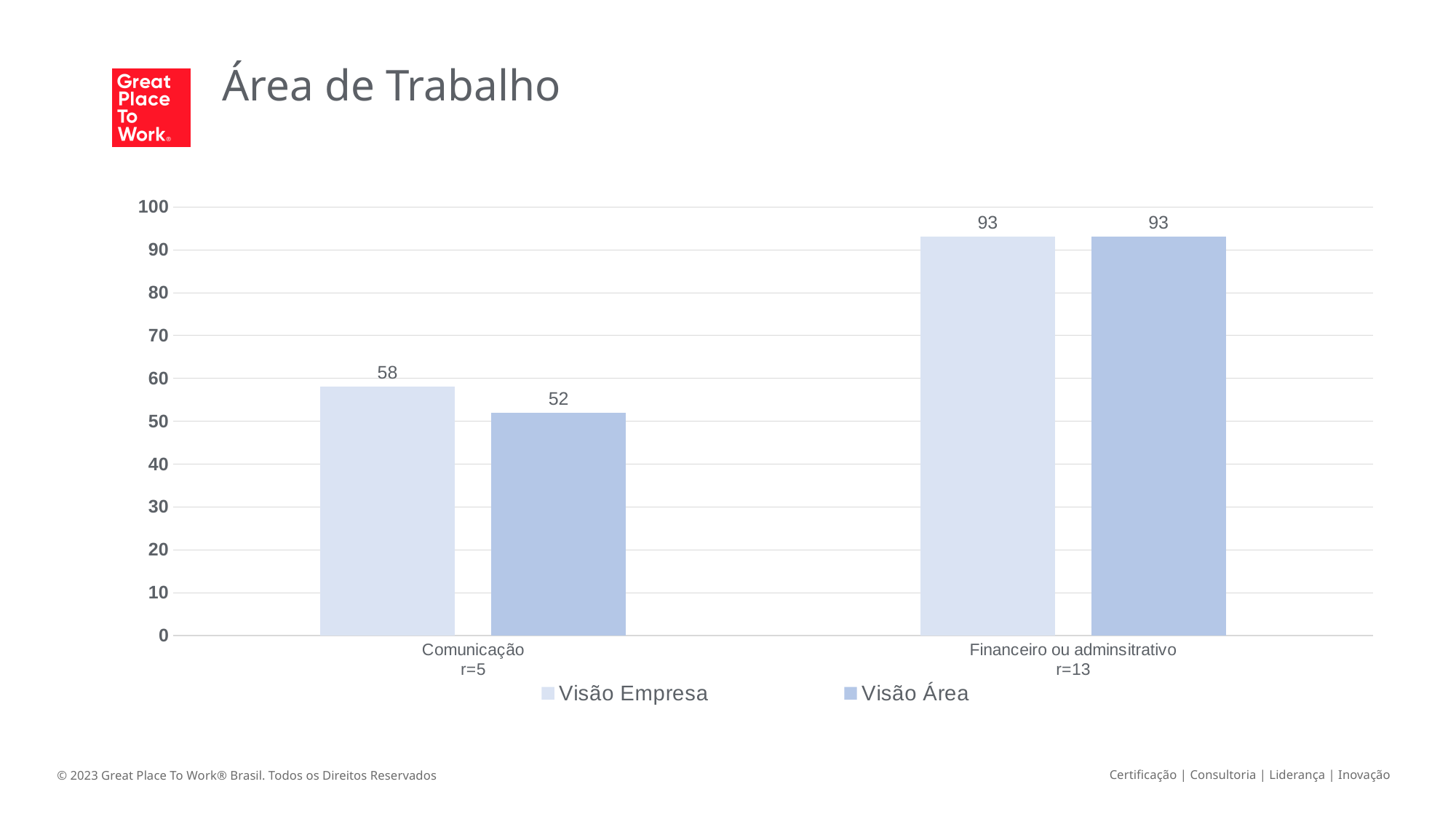
What kind of chart is shown on the slide? Bar chart What is the Visão Área value for Financeiro ou adminsitrativo? 93 What is the Visão Empresa value for Financeiro ou adminsitrativo? 93 Which category has the lowest Visão Área value? Comunicação For Comunicação, which is larger: Visão Empresa or Visão Área? Visão Empresa How many series does the legend list? 2 What is the Visão Empresa value for Comunicação? 58 Which category has the highest Visão Empresa value? Financeiro ou adminsitrativo What is the difference between the Visão Empresa and Visão Área values for Comunicação? 6 What is the title of the slide? Área de Trabalho How many categories are shown on the x axis? 2 What is the Visão Área value for Comunicação? 52